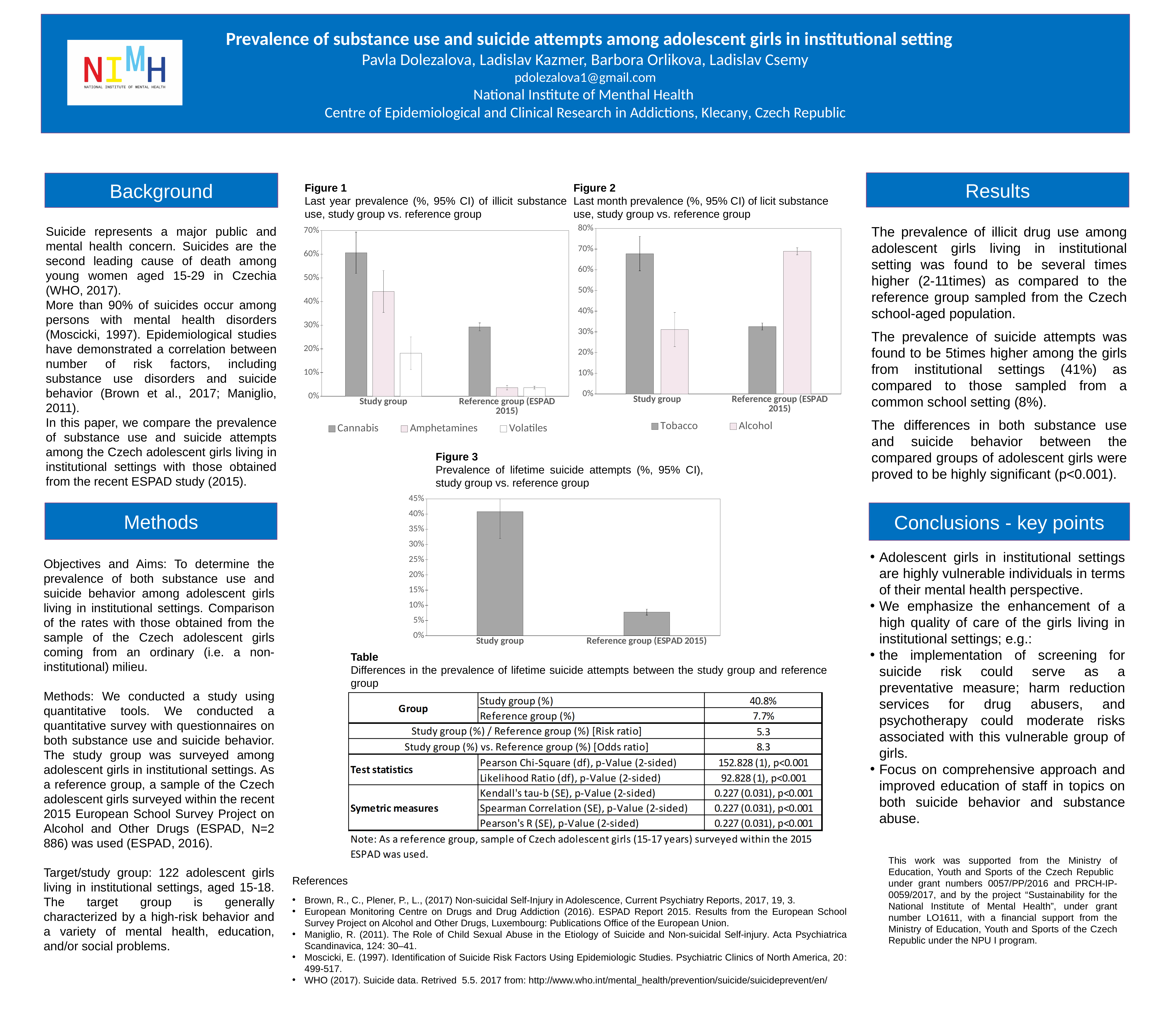
How many series does the legend of Figure 1 list? 3 In Figure 2, which substance has the higher value in the reference group (ESPAD 2015)? Alcohol In Figure 3, is the value for the study group greater or less than 30%? greater How many categories are shown on the x axis of Figure 3? 2 In Figure 1, which substance has the highest last year prevalence in the study group? Cannabis What kind of chart is Figure 1? bar chart In Figure 1, which group has the larger value for Volatiles, the study group or the reference group? Study group In Figure 3, which group has the higher prevalence of lifetime suicide attempts? Study group In Figure 1, is the value for Cannabis in the study group greater or less than 50%? greater How many series does the legend of Figure 2 list? 2 In Figure 2, is the value for Tobacco in the study group greater or less than 60%? greater In Figure 2, which group has the larger value for Alcohol, the study group or the reference group? Reference group (ESPAD 2015)